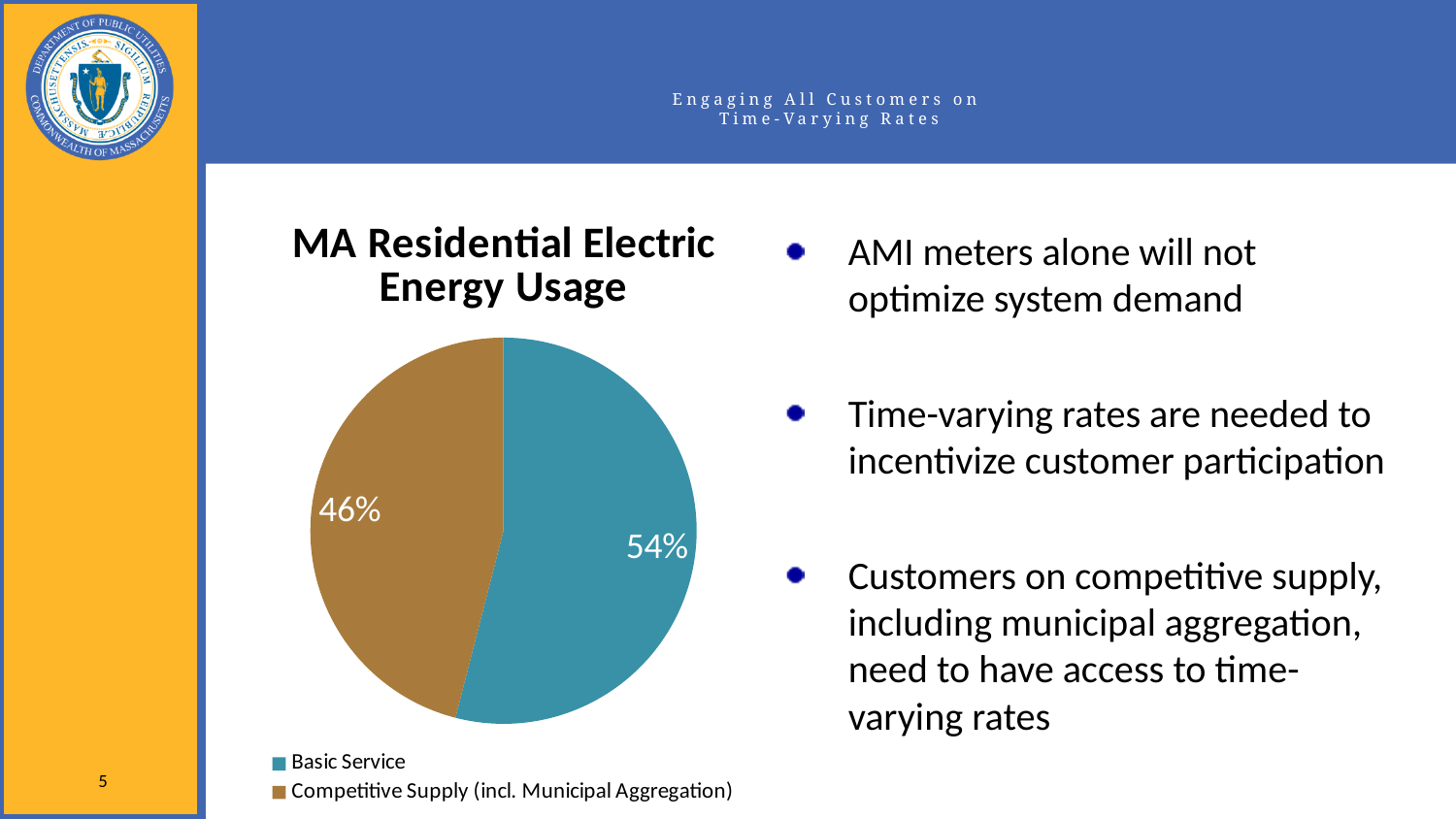
How many slices does the pie chart have? 2 What is the difference in percentage points between the Basic Service share and the Competitive Supply share? 8 Which colour represents Basic Service in the pie chart? Teal (blue-green) What kind of chart is shown on the slide? Pie chart Which category has the largest share of the pie? Basic Service How many entries does the legend list? 2 Which category has the smallest share of the pie? Competitive Supply (incl. Municipal Aggregation) What is the title of the chart? MA Residential Electric Energy Usage What share of MA residential electric energy usage is Competitive Supply (incl. Municipal Aggregation)? 46% Which is larger, the Basic Service share or the Competitive Supply share? Basic Service What share of MA residential electric energy usage is Basic Service? 54% Is the Basic Service share greater or less than 50%? greater